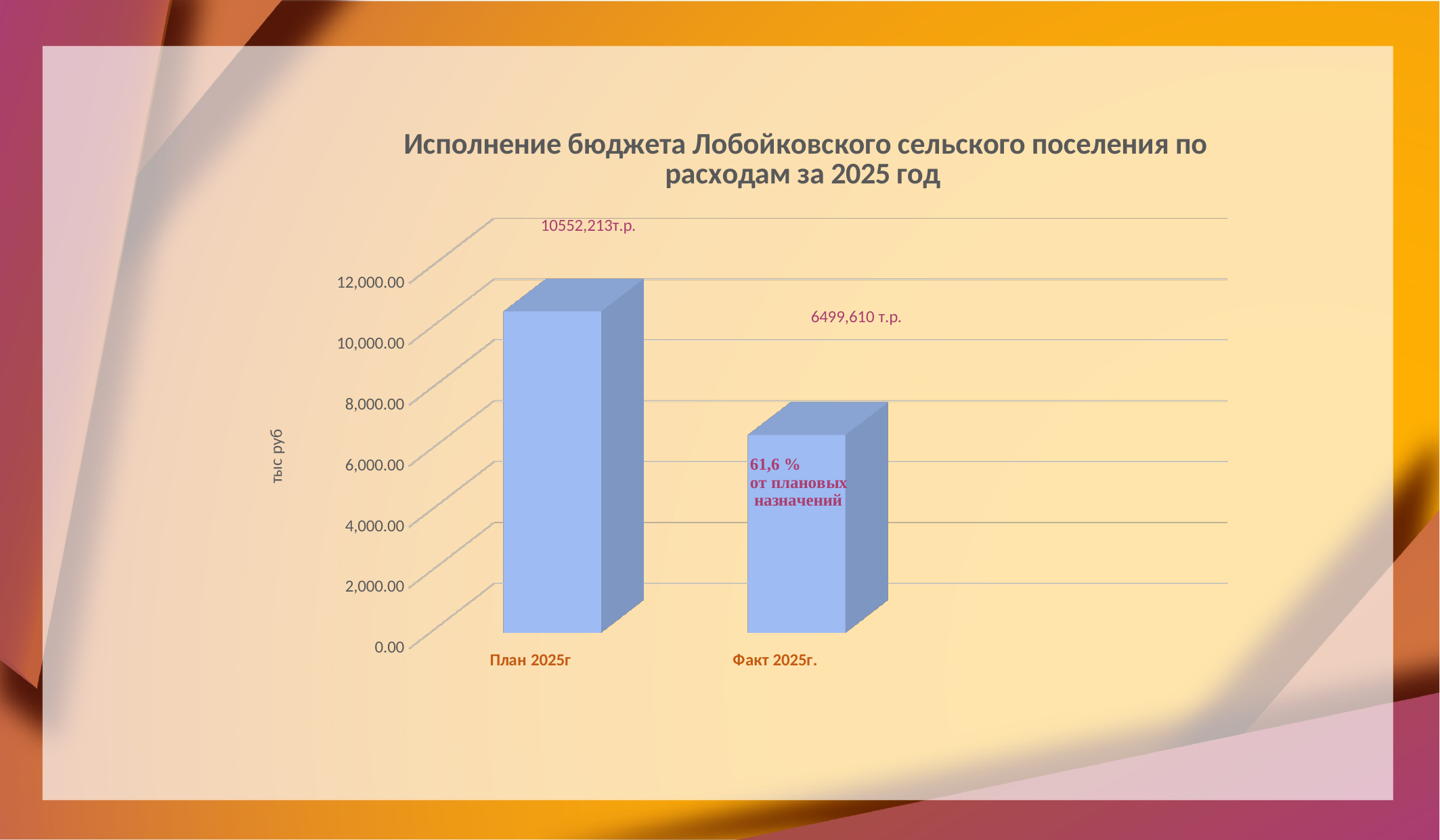
What is the value for Факт 2025г.? 6499,610 т.р. What percentage of planned appropriations does the Факт 2025г. value represent, according to the chart annotation? 61,6 % Which category has the highest value? План 2025г Is the value for Факт 2025г. greater or less than 8,000.00? less Which is larger, the value for План 2025г or for Факт 2025г.? План 2025г What is the value for План 2025г? 10552,213 т.р. What is the difference between the План 2025г and Факт 2025г. values? 4052,603 т.р. What kind of chart is shown on the slide? Bar chart What is the label of the vertical axis? тыс руб Which category has the lowest value? Факт 2025г. Is the value for План 2025г greater or less than 10,000.00? greater How many categories are shown on the chart? 2